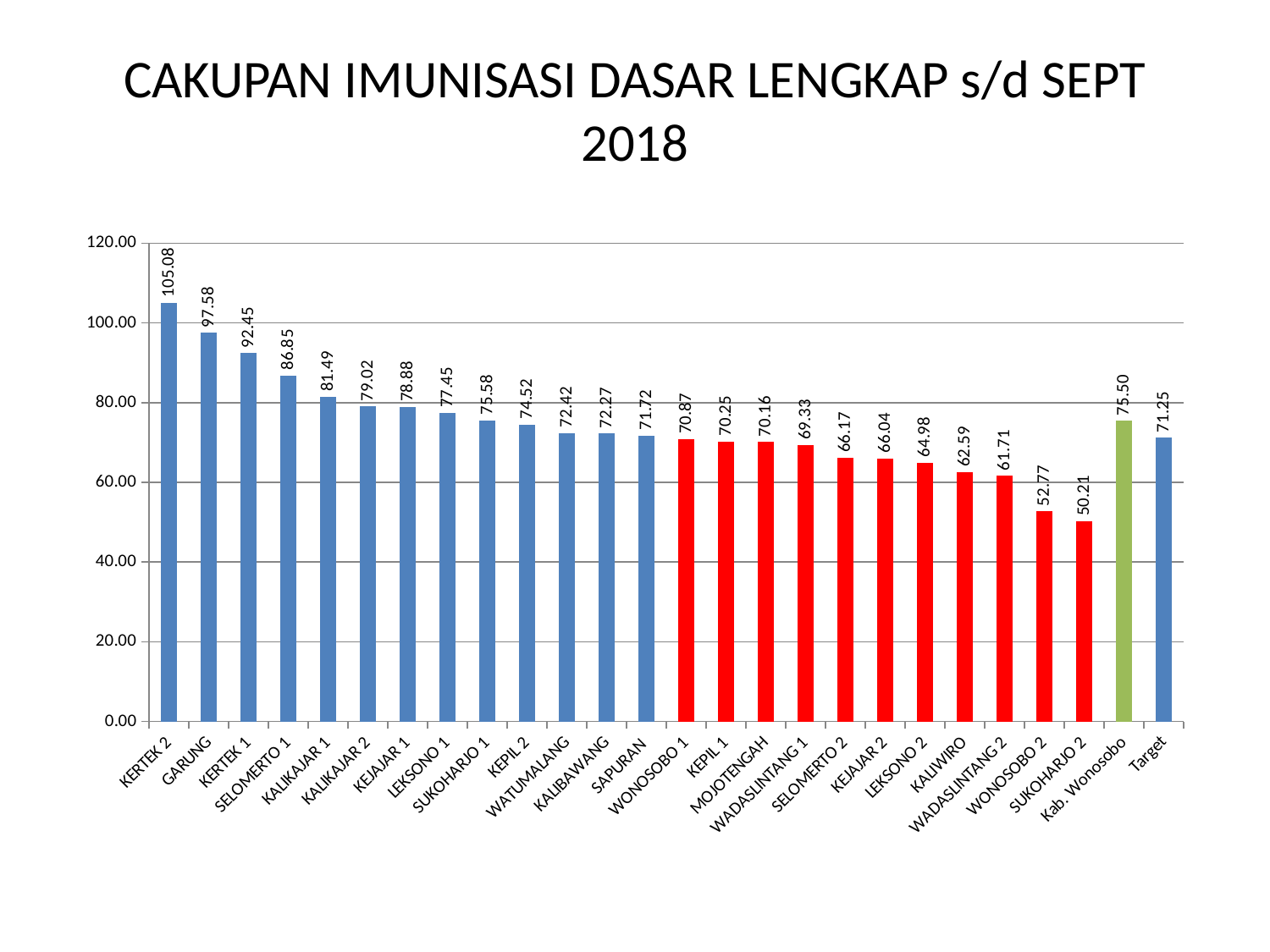
What is the value for KERTEK 2? 105.08 What is the value for Kab. Wonosobo? 75.50 What is the difference between the values for Kab. Wonosobo and Target? 4.25 Which is larger, the value for KALIWIRO or the value for WONOSOBO 2? KALIWIRO Which category has the highest value? KERTEK 2 What is the value for Target? 71.25 How many bars are shown in the chart? 26 What is the difference between the values for KERTEK 2 and GARUNG? 7.50 What kind of chart is shown on the slide? Bar chart What is the value for WADASLINTANG 1? 69.33 Is the value for SELOMERTO 1 greater or less than 80.00? greater Which category has the lowest value? SUKOHARJO 2